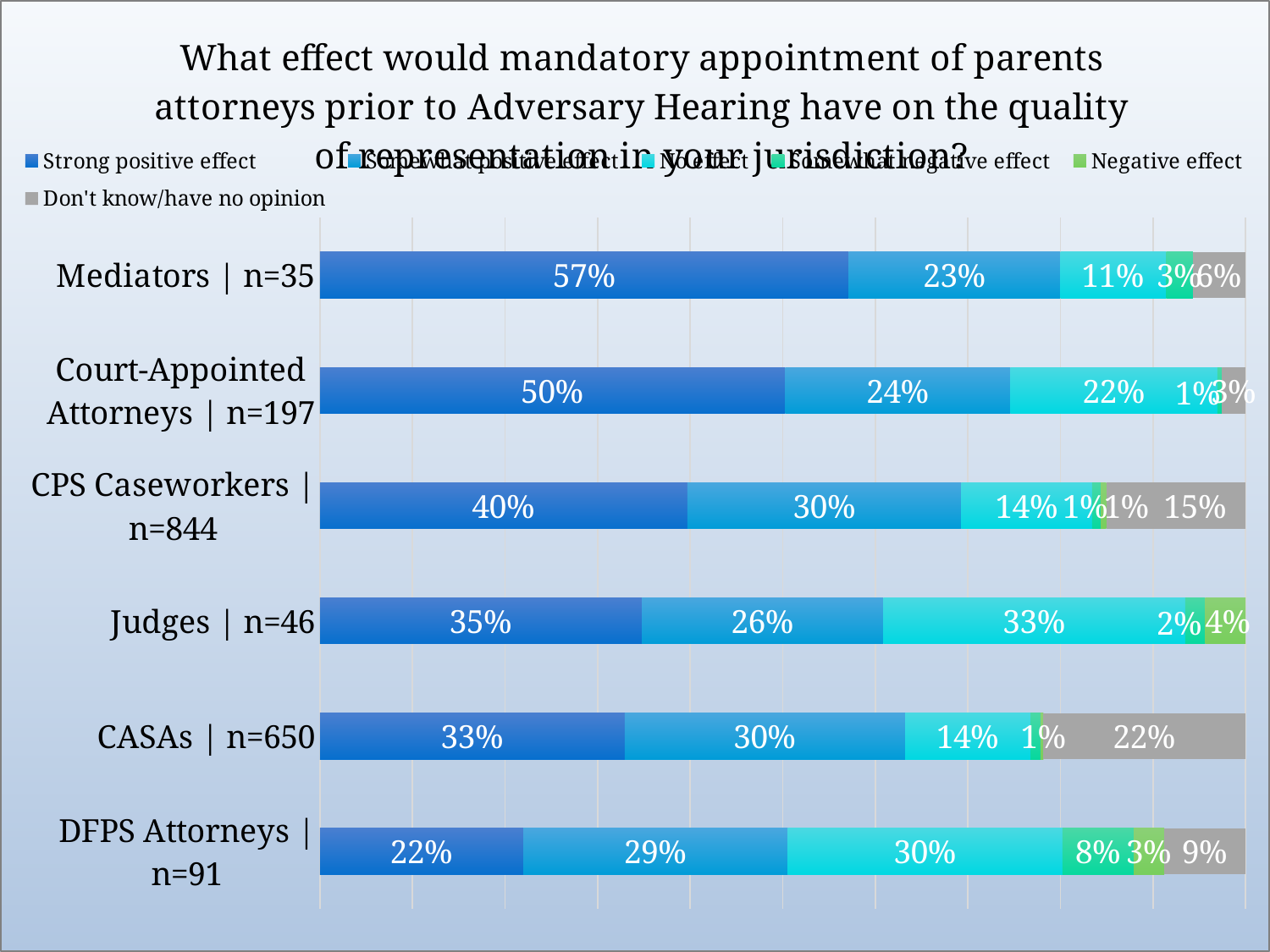
What percentage of Mediators reported a strong positive effect? 57% Which is larger: the "Don't know/have no opinion" share for CASAs or for DFPS Attorneys? CASAs What is the difference between the "Strong positive effect" percentages for Mediators and Court-Appointed Attorneys? 7% How many respondent groups are shown in the chart? 6 What percentage of DFPS Attorneys reported a somewhat negative effect? 8% What kind of chart is shown on the slide? Stacked bar chart How many series does the legend list? 6 Which respondent group has the lowest percentage for "Strong positive effect"? DFPS Attorneys | n=91 What percentage of CPS Caseworkers answered "Don't know/have no opinion"? 15% What is the sample size (n) for the CASAs group? 650 Which respondent group has the highest percentage for "Strong positive effect"? Mediators | n=35 What percentage of Judges reported no effect? 33%